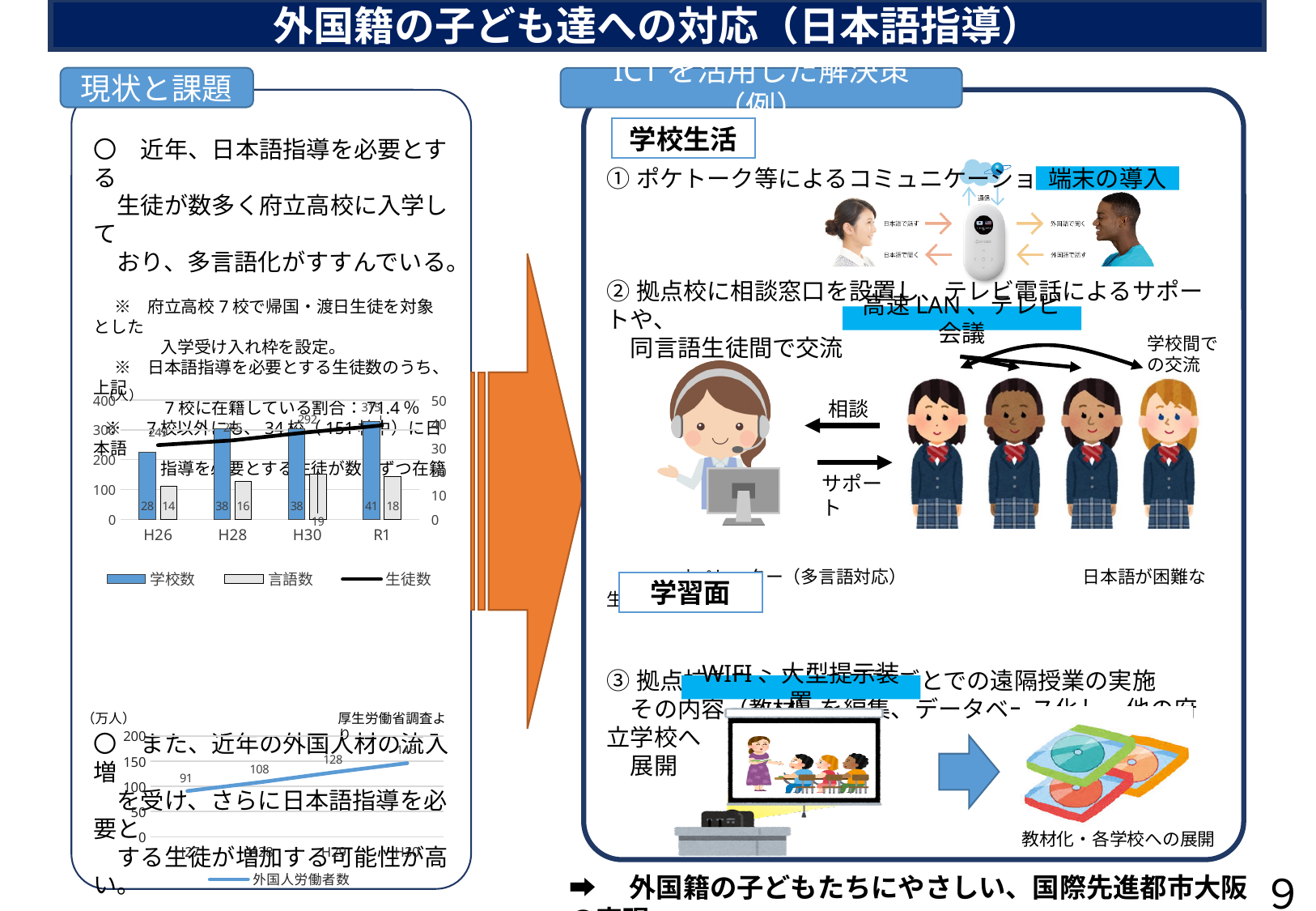
In the top-left chart, which category has the highest 学校数 value? R1 In the bottom-left chart, what is the value of the first data point of 外国人労働者数? 91 In the top-left chart, how many categories are shown on the x axis? 4 In the top-left chart, what is the value of 学校数 for H26? 28 In the top-left chart, does the 生徒数 line rise or fall from H26 to R1? rise In the top-left chart, what is the difference between the 学校数 values for H28 and H26? 10 In the top-left chart, how many series does the legend list? 3 In the top-left chart, which category has the lowest 言語数 value? H26 In the top-left chart, is the 言語数 value for R1 larger or smaller than the 言語数 value for H30? smaller In the top-left chart, what is the value of 学校数 for R1? 41 In the bottom-left chart, what is the difference between the third data point (128) and the second data point (108)? 20 In the top-left chart, what is the value of 言語数 for H30? 19